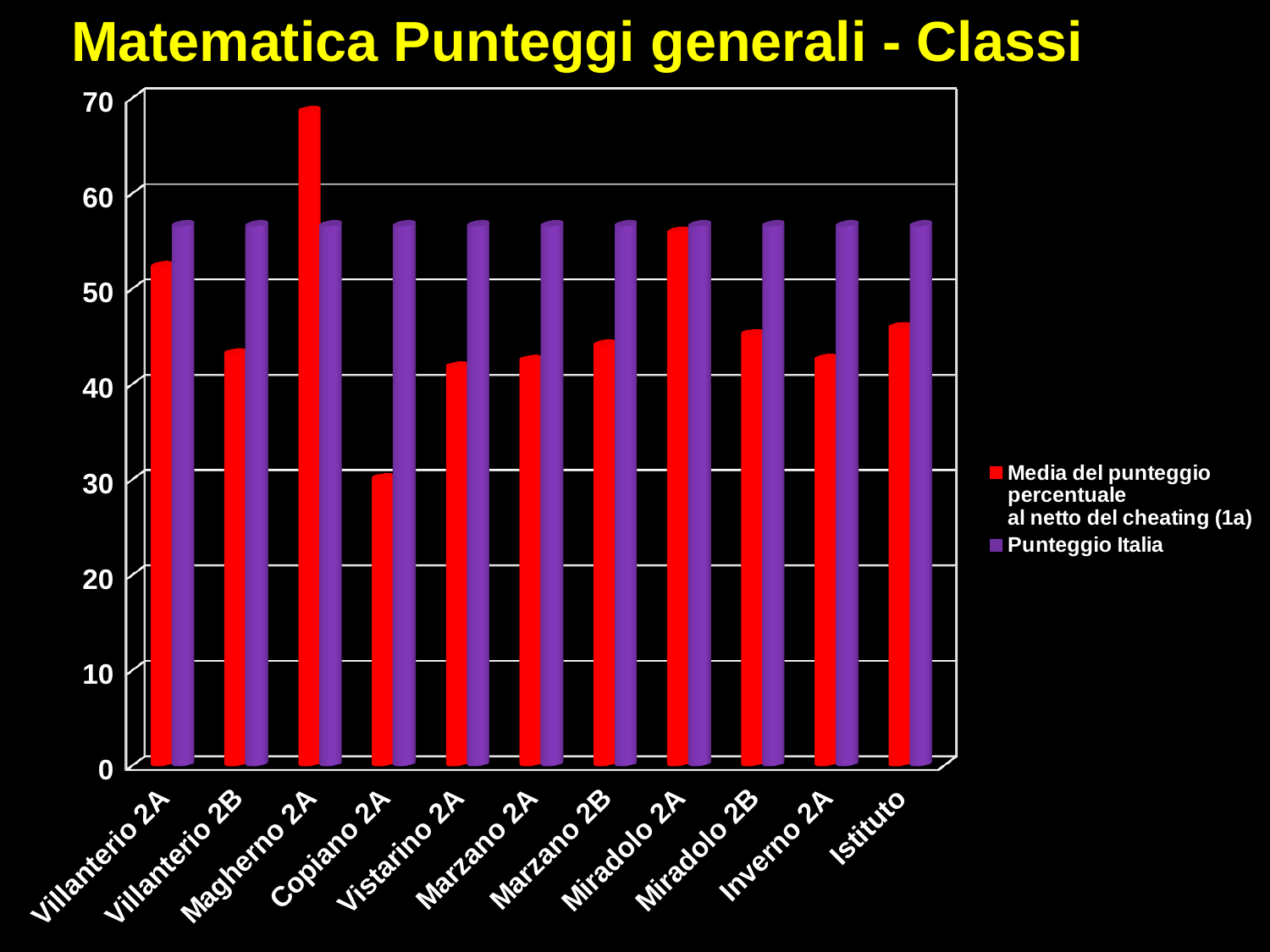
Is the 'Media del punteggio percentuale al netto del cheating (1a)' value for Magherno 2A greater or less than 60? greater Is the 'Media del punteggio percentuale al netto del cheating (1a)' value for Istituto greater or less than 50? less Which colour represents the 'Punteggio Italia' series? purple What is the title of the chart? Matematica Punteggi generali - Classi What kind of chart is shown on the slide? bar chart Which category has the highest value for 'Media del punteggio percentuale al netto del cheating (1a)'? Magherno 2A Which is larger for Magherno 2A: the 'Media del punteggio percentuale al netto del cheating (1a)' bar or the 'Punteggio Italia' bar? Media del punteggio percentuale al netto del cheating (1a) Which is larger for Villanterio 2A: the 'Media del punteggio percentuale al netto del cheating (1a)' bar or the 'Punteggio Italia' bar? Punteggio Italia How many classes/categories are shown on the x axis? 11 How many series does the legend list? 2 Which category has the lowest value for 'Media del punteggio percentuale al netto del cheating (1a)'? Copiano 2A Is the 'Media del punteggio percentuale al netto del cheating (1a)' value for Copiano 2A greater or less than 40? less